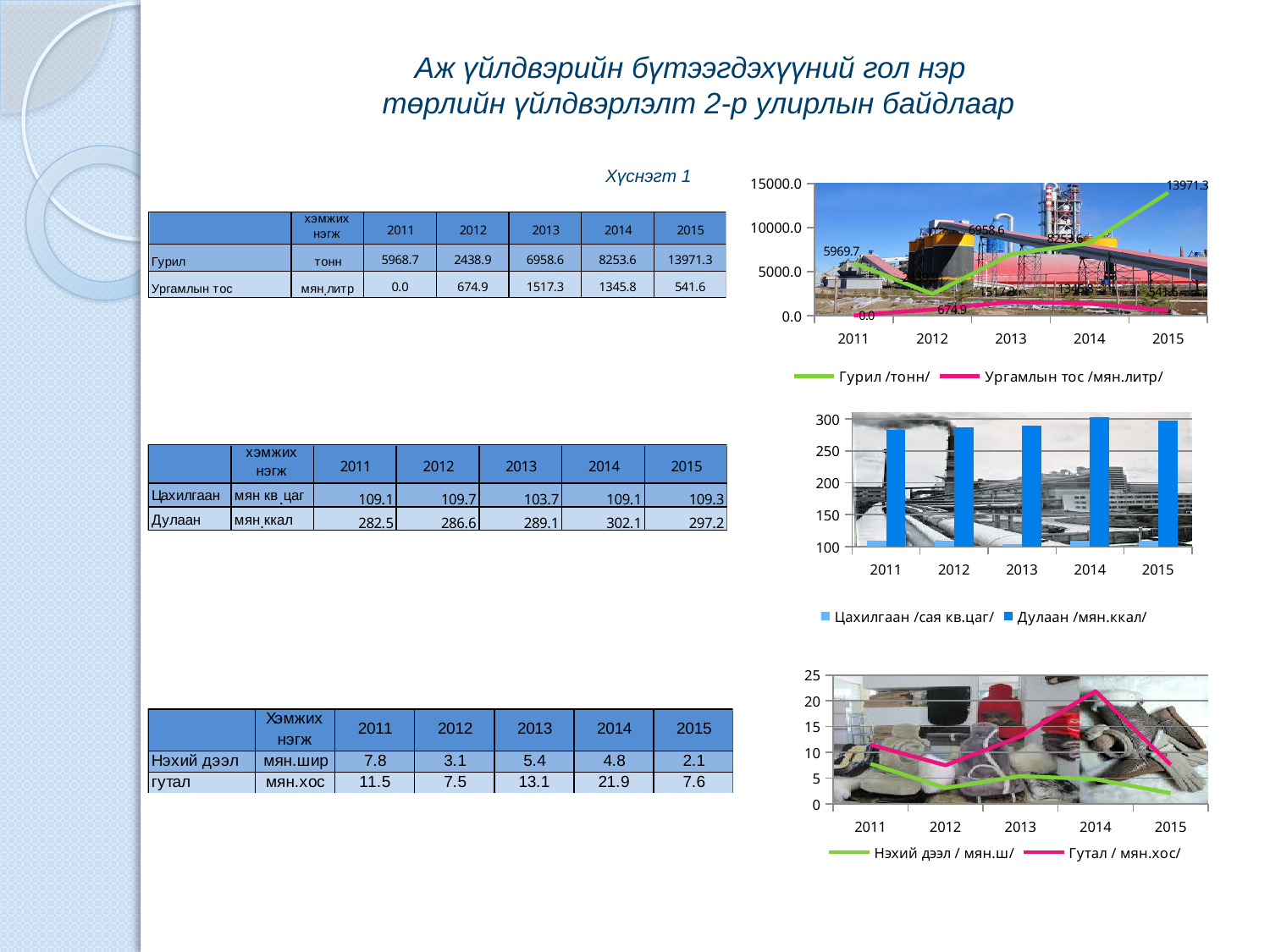
In the top chart on the right, what is the value for Ургамлын тос /мян.литр/ in 2011? 0.0 What kind of chart is the middle chart on the right (Цахилгаан / Дулаан)? bar chart In the top chart on the right, how many series does the legend list? 2 In the top chart on the right, what is the value for Ургамлын тос /мян.литр/ in 2012? 674.9 In the bottom chart on the right, which year has the highest value for Гутал / мян.хос/? 2014 What kind of chart is the top chart on the right (Гурил / Ургамлын тос)? line chart In the bottom chart on the right, which series has the larger value in 2013, Нэхий дээл or Гутал? Гутал In the middle chart on the right, is the value for Дулаан /мян.ккал/ in 2011 greater or less than 250? greater In the top chart on the right, what is the value for Гурил /тонн/ in 2015? 13971.3 In the top chart on the right, what is the difference between the Гурил /тонн/ values for 2015 and 2014? 5717.7 In the top chart on the right, which year has the highest value for Гурил /тонн/? 2015 In the middle chart on the right, how many years are shown on the x axis? 5